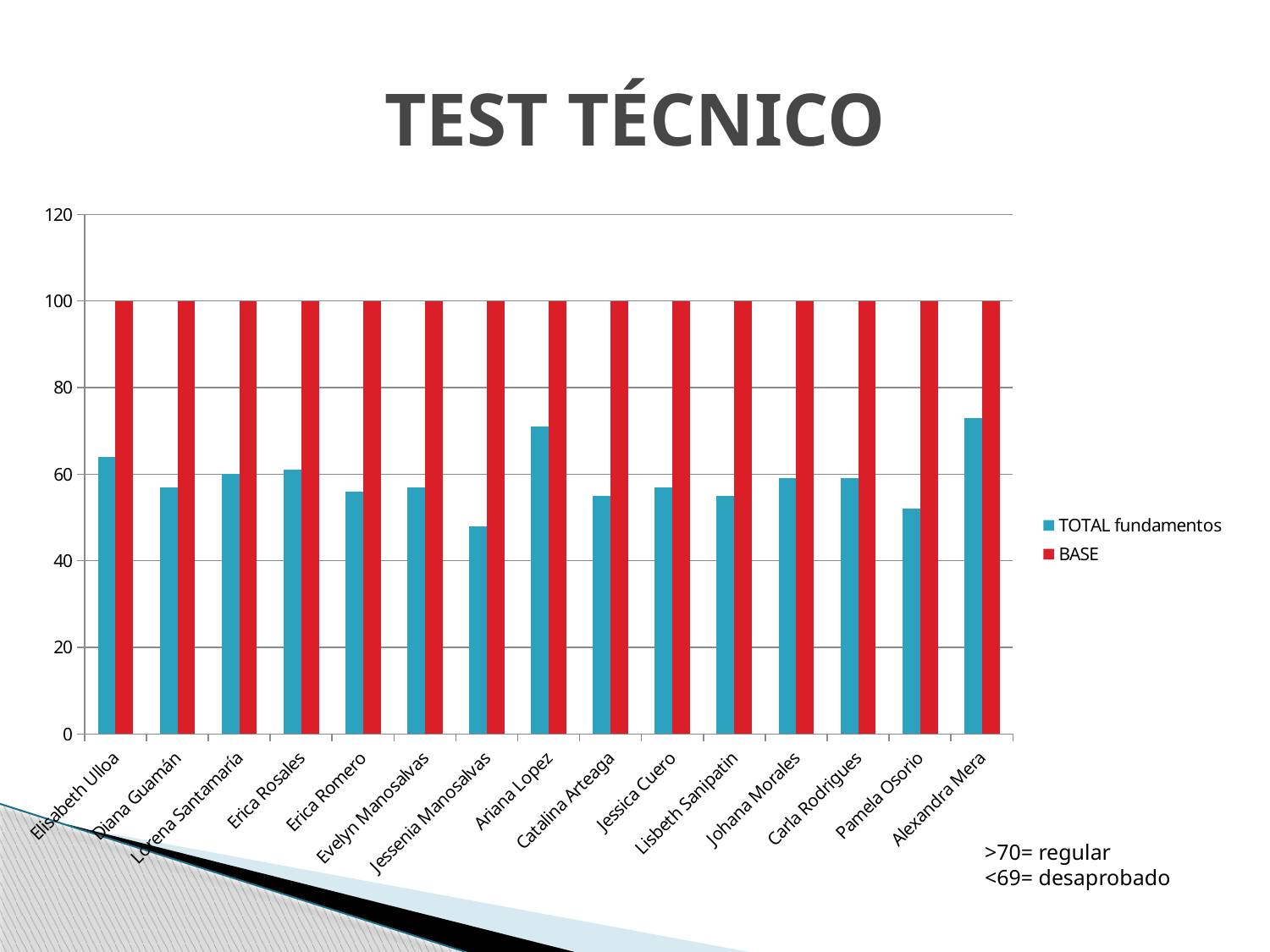
What kind of chart is shown on the slide? bar chart What is the title of the slide? TEST TÉCNICO What is the BASE value for Alexandra Mera? 100 How many series does the legend list? 2 Is the TOTAL fundamentos value for Ariana Lopez greater or less than 60? greater Which person has the lowest TOTAL fundamentos value? Jessenia Manosalvas Which is larger, the TOTAL fundamentos value for Elisabeth Ulloa or for Diana Guamán? Elisabeth Ulloa What is the BASE value for Elisabeth Ulloa? 100 Which series is shown in red? BASE Is the TOTAL fundamentos value for Pamela Osorio greater or less than 60? less How many people (categories) are shown on the x axis? 15 Is the TOTAL fundamentos value for Jessenia Manosalvas greater or less than 60? less